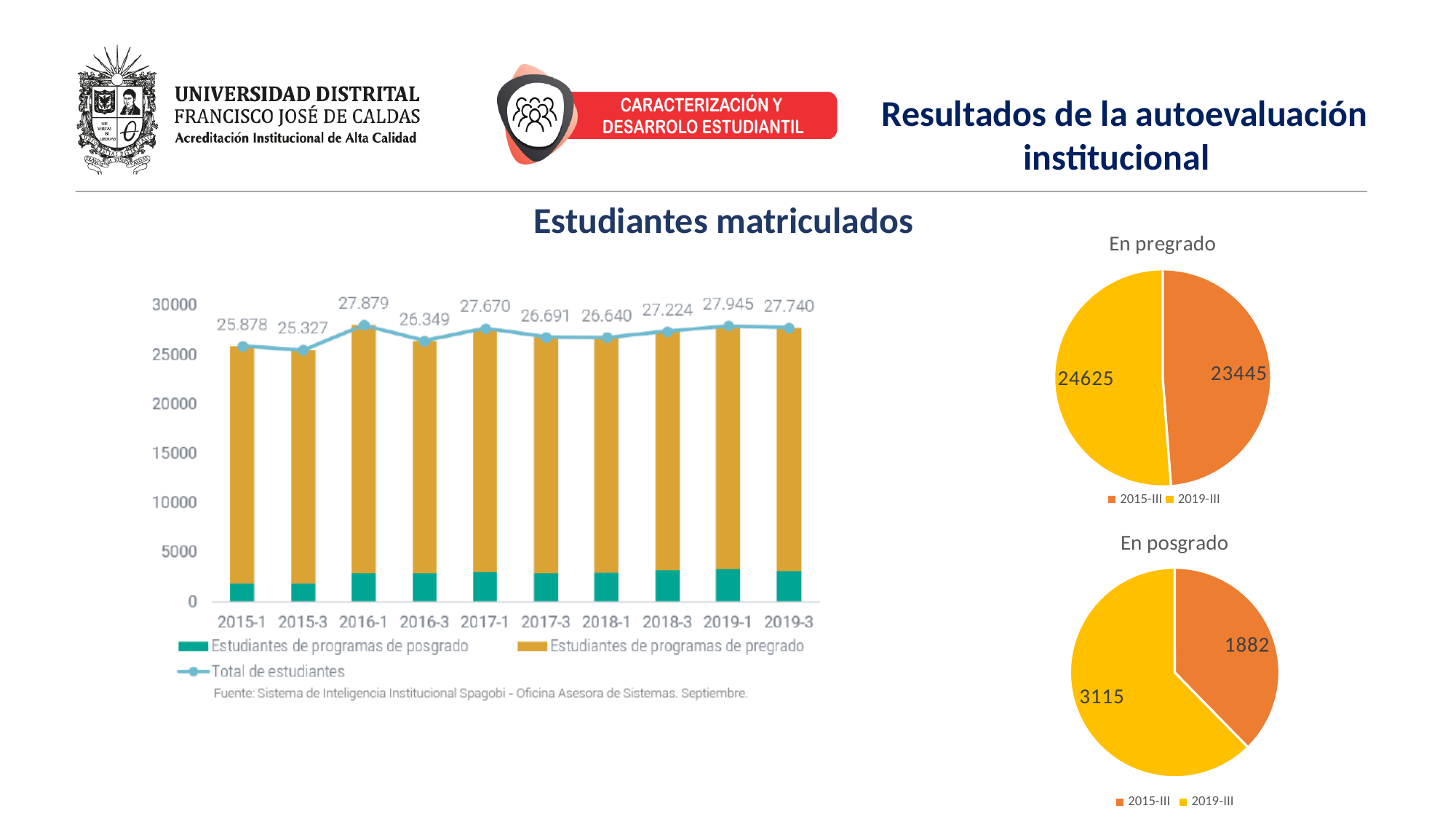
In the 'Estudiantes matriculados' chart, what is the total number of students for 2016-1? 27.879 How many series does the legend of the 'Estudiantes matriculados' chart list? 3 In the 'Estudiantes matriculados' chart, what is the difference between the total for 2019-1 and the total for 2015-3? 2.618 In the 'Estudiantes matriculados' chart, which period has a larger total of students, 2017-1 or 2017-3? 2017-1 In the 'Estudiantes matriculados' chart, is the value for 'Estudiantes de programas de posgrado' in 2019-1 greater or less than 5000? less In the 'Estudiantes matriculados' chart, which period has the lowest total number of students? 2015-3 In the 'Estudiantes matriculados' chart, which period has the highest total number of students? 2019-1 How many periods are shown on the x axis of the 'Estudiantes matriculados' chart? 10 What kind of chart is the 'En posgrado' chart? pie chart In the 'En posgrado' pie chart, what is the value for 2015-III? 1882 In the 'Estudiantes matriculados' chart, what is the total number of students for 2018-3? 27.224 In the 'En pregrado' pie chart, what is the value for 2019-III? 24625